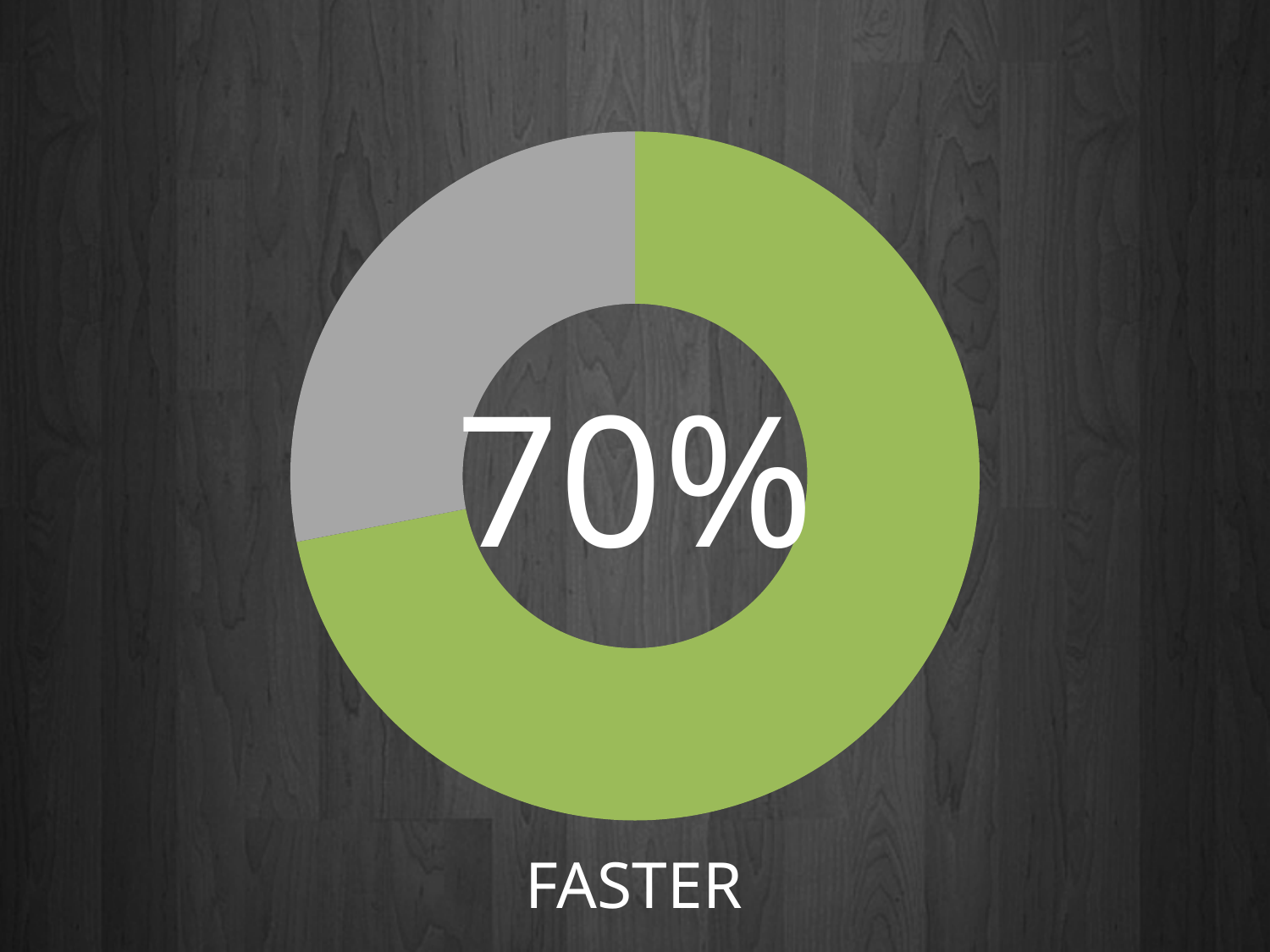
What kind of chart is shown on the slide? doughnut chart Which colour segment takes up the largest part of the doughnut chart? green What share of the doughnut chart does the green segment represent? 70% What colour is the segment that represents 70% in the doughnut chart? green Which segment of the doughnut chart is larger, the green one or the grey one? green Which colour segment takes up the smallest part of the doughnut chart? grey What percentage is printed in the centre of the doughnut chart? 70% What word is written below the doughnut chart? FASTER How many segments does the doughnut chart have? 2